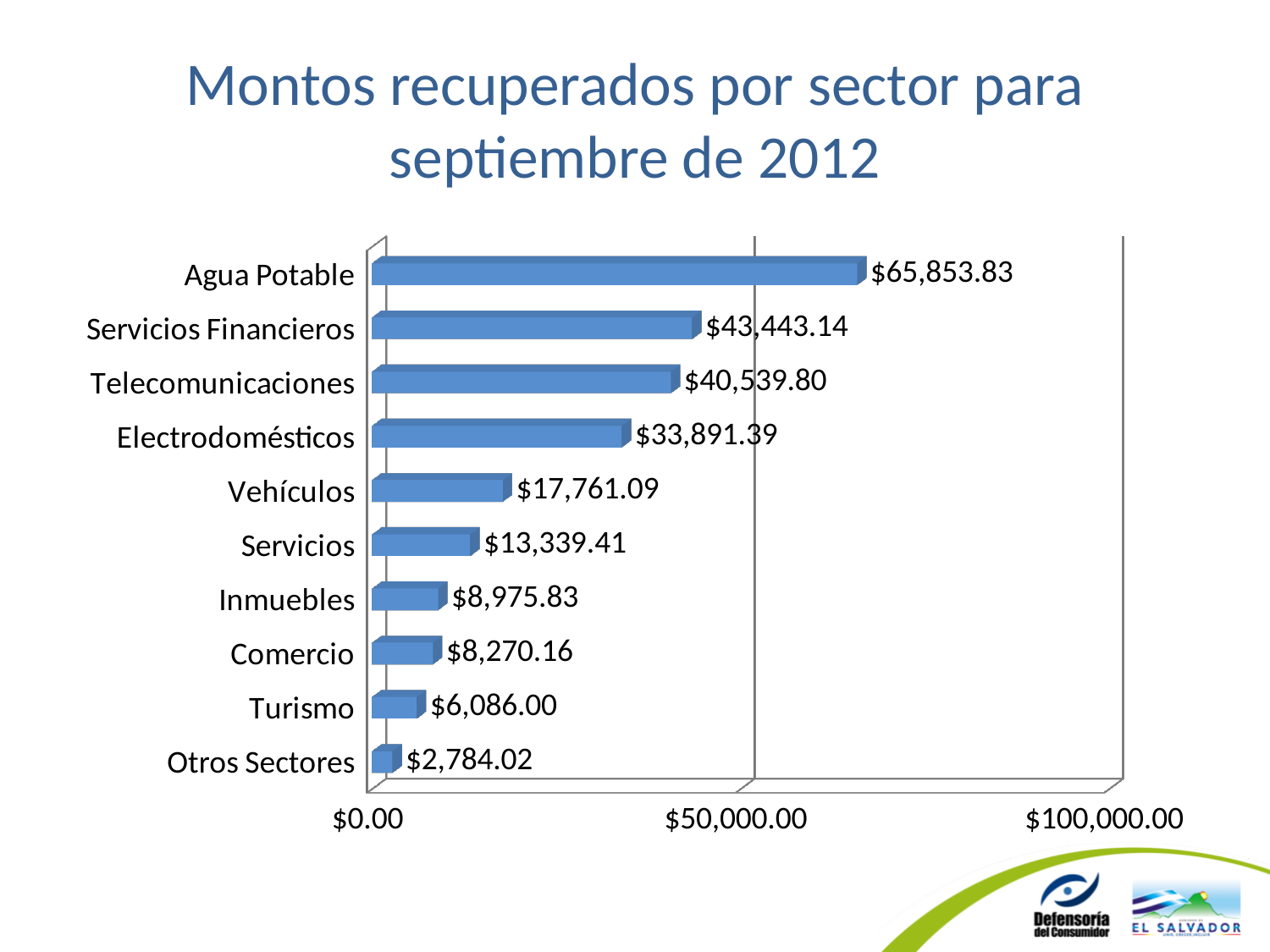
Which sector has the highest recovered amount? Agua Potable What is the difference between the values for Agua Potable and Servicios Financieros? $22,410.69 How many sectors are shown in the chart? 10 What is the value for Telecomunicaciones? $40,539.80 Is the value for Agua Potable greater or less than $50,000.00? greater What kind of chart is shown on the slide? Bar chart Which is larger, the value for Vehículos or the value for Servicios? Vehículos What is the title of the chart? Montos recuperados por sector para septiembre de 2012 What is the value for Agua Potable? $65,853.83 What is the difference between the values for Inmuebles and Comercio? $705.67 What is the value for Turismo? $6,086.00 Which sector has the lowest recovered amount? Otros Sectores